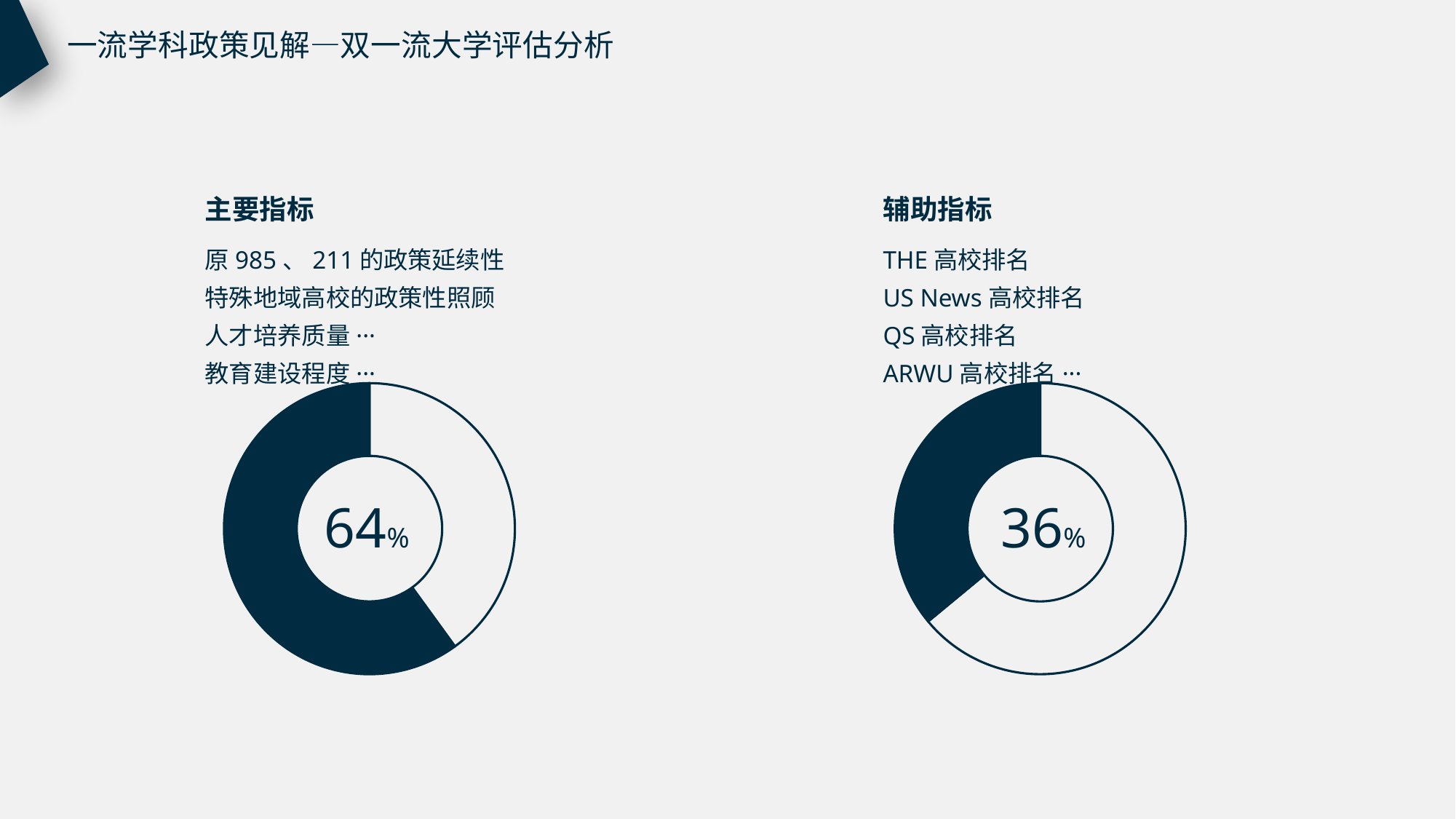
In the right donut chart, is the filled dark portion greater or less than 50%? less What is the total of the two percentages shown in the left and right donut charts? 100% What percentage is shown in the centre of the left donut chart under 主要指标? 64% How many donut charts are on the slide? 2 Which is larger, the percentage in the left chart (主要指标) or the percentage in the right chart (辅助指标)? 主要指标 (64%) What heading appears above the right donut chart? 辅助指标 What kind of chart is used on this slide to show the 64% and 36% values? Donut chart In the left donut chart, is the filled dark portion greater or less than 50%? greater What is the difference between the percentage in the left chart (64%) and the percentage in the right chart (36%)? 28% What heading appears above the left donut chart? 主要指标 What percentage is shown in the centre of the right donut chart under 辅助指标? 36%